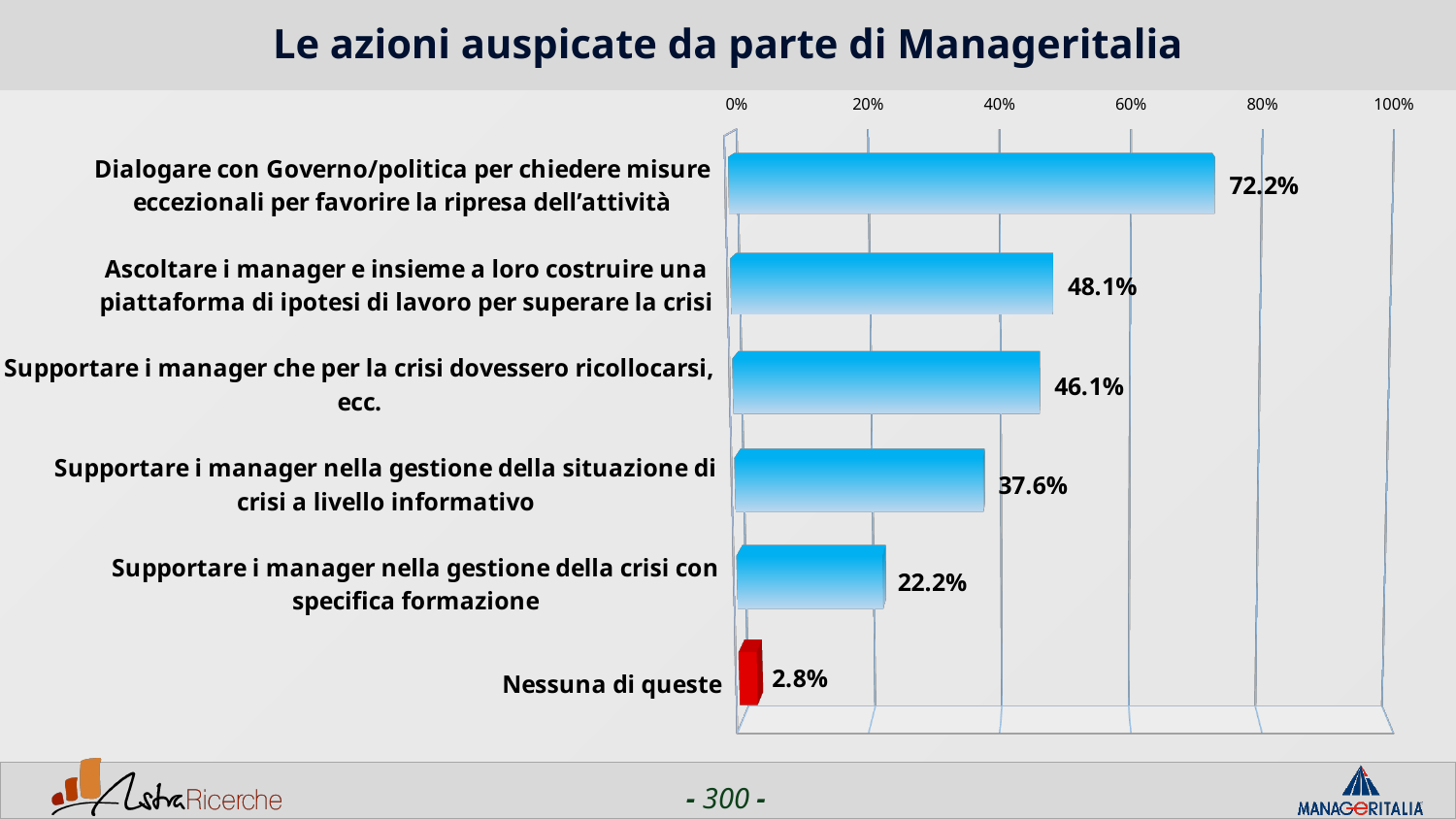
What kind of chart is shown on the slide? Bar chart What is the value for "Ascoltare i manager e insieme a loro costruire una piattaforma di ipotesi di lavoro per superare la crisi"? 48.1% Which category has the highest value? Dialogare con Governo/politica per chiedere misure eccezionali per favorire la ripresa dell'attività Which bar is coloured red instead of blue? Nessuna di queste What is the value for "Supportare i manager nella gestione della crisi con specifica formazione"? 22.2% Which is larger: the value for "Ascoltare i manager..." or the value for "Supportare i manager che per la crisi dovessero ricollocarsi, ecc."? Ascoltare i manager e insieme a loro costruire una piattaforma di ipotesi di lavoro per superare la crisi What is the difference between the values for "Dialogare con Governo/politica..." (72.2%) and "Supportare i manager nella gestione della situazione di crisi a livello informativo" (37.6%)? 34.6% What is the title of the slide? Le azioni auspicate da parte di Manageritalia Which category has the lowest value? Nessuna di queste What is the value for "Nessuna di queste"? 2.8% Is the value for "Supportare i manager nella gestione della situazione di crisi a livello informativo" greater or less than 40%? less How many categories are shown in the chart? 6